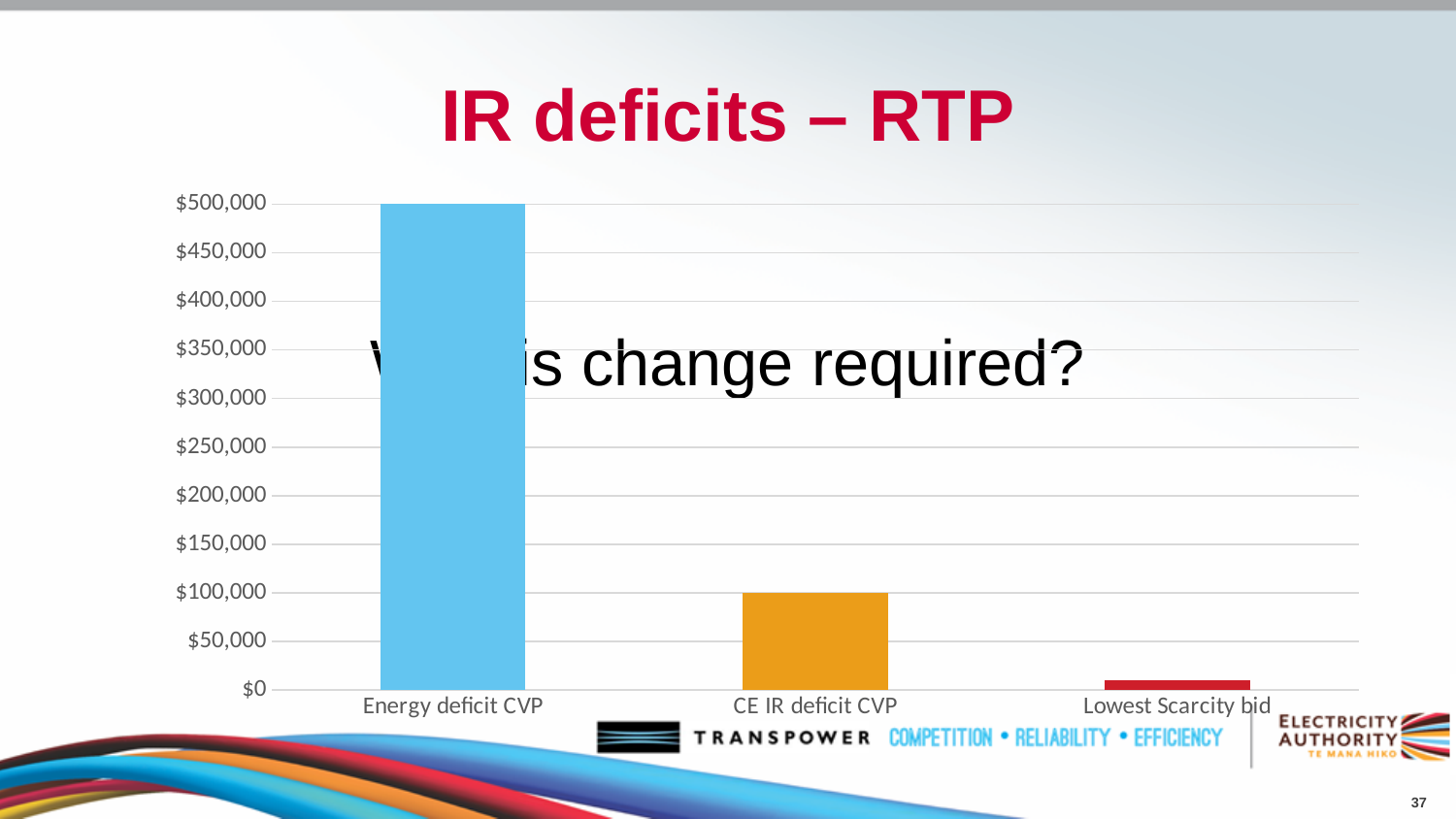
What is the value for CE IR deficit CVP? $100,000 Is the value for Lowest Scarcity bid greater or less than $50,000? less Is the value for Energy deficit CVP greater or less than $450,000? greater Which category has the highest value? Energy deficit CVP Which is larger, CE IR deficit CVP or Lowest Scarcity bid? CE IR deficit CVP Do the values rise or fall from left to right across the categories? fall How many categories are plotted in the chart? 3 What kind of chart is shown on the slide? bar chart What is the difference between the values for Energy deficit CVP and CE IR deficit CVP? $400,000 What is the value for Energy deficit CVP? $500,000 Which category has the lowest value? Lowest Scarcity bid What is the title of the slide containing the chart? IR deficits – RTP